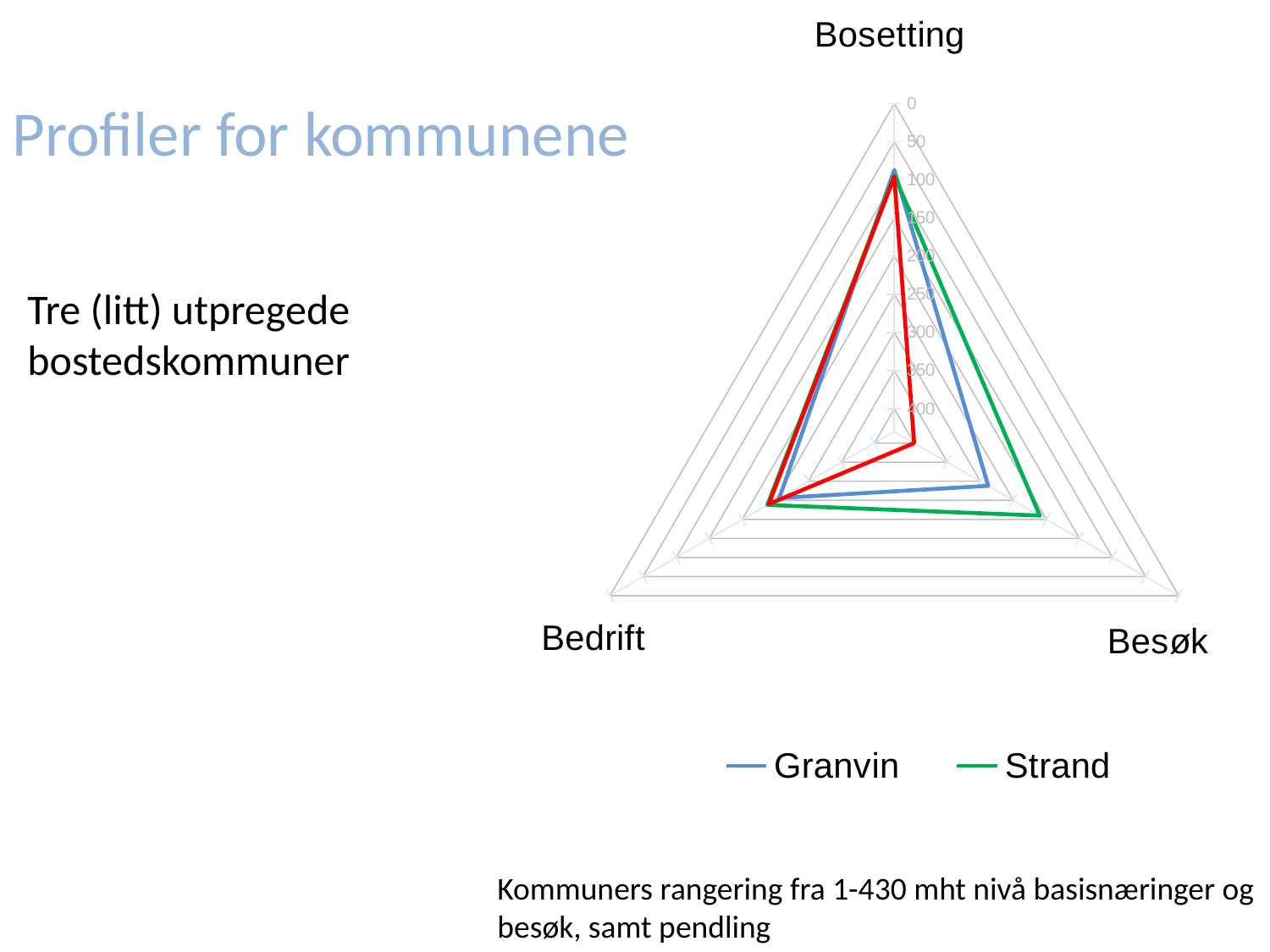
How many series does the chart legend list? 2 What kind of chart is shown on the slide? Radar chart Which series are named in the chart legend? Granvin and Strand How many axes (categories) does the radar chart have? 3 What is the highest tick value printed on the chart's scale? 400 Which legend series extends furthest toward the Besøk corner of the chart? Strand What are the three axis labels on the radar chart? Bosetting, Bedrift, Besøk